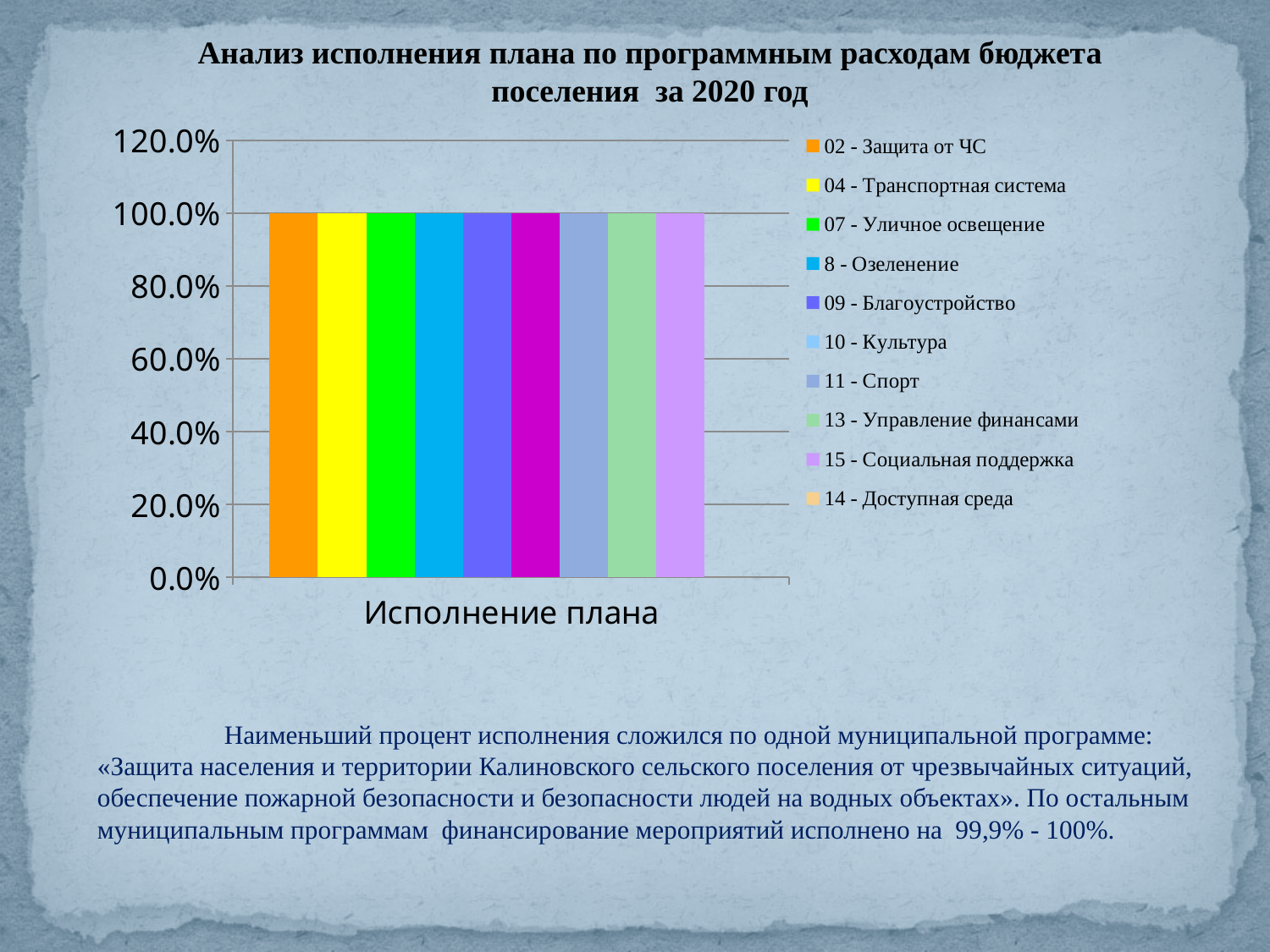
What colour is the bar for "02 - Защита от ЧС"? orange Is the value for "15 - Социальная поддержка" greater or less than 40.0%? greater Is the value for "09 - Благоустройство" greater or less than 80.0%? greater Is the value for "07 - Уличное освещение" greater or less than 80.0%? greater What is the title of the chart? Анализ исполнения плана по программным расходам бюджета поселения за 2020 год How many series does the legend list? 10 What kind of chart is shown on the slide? bar chart How many categories are shown on the x axis? 1